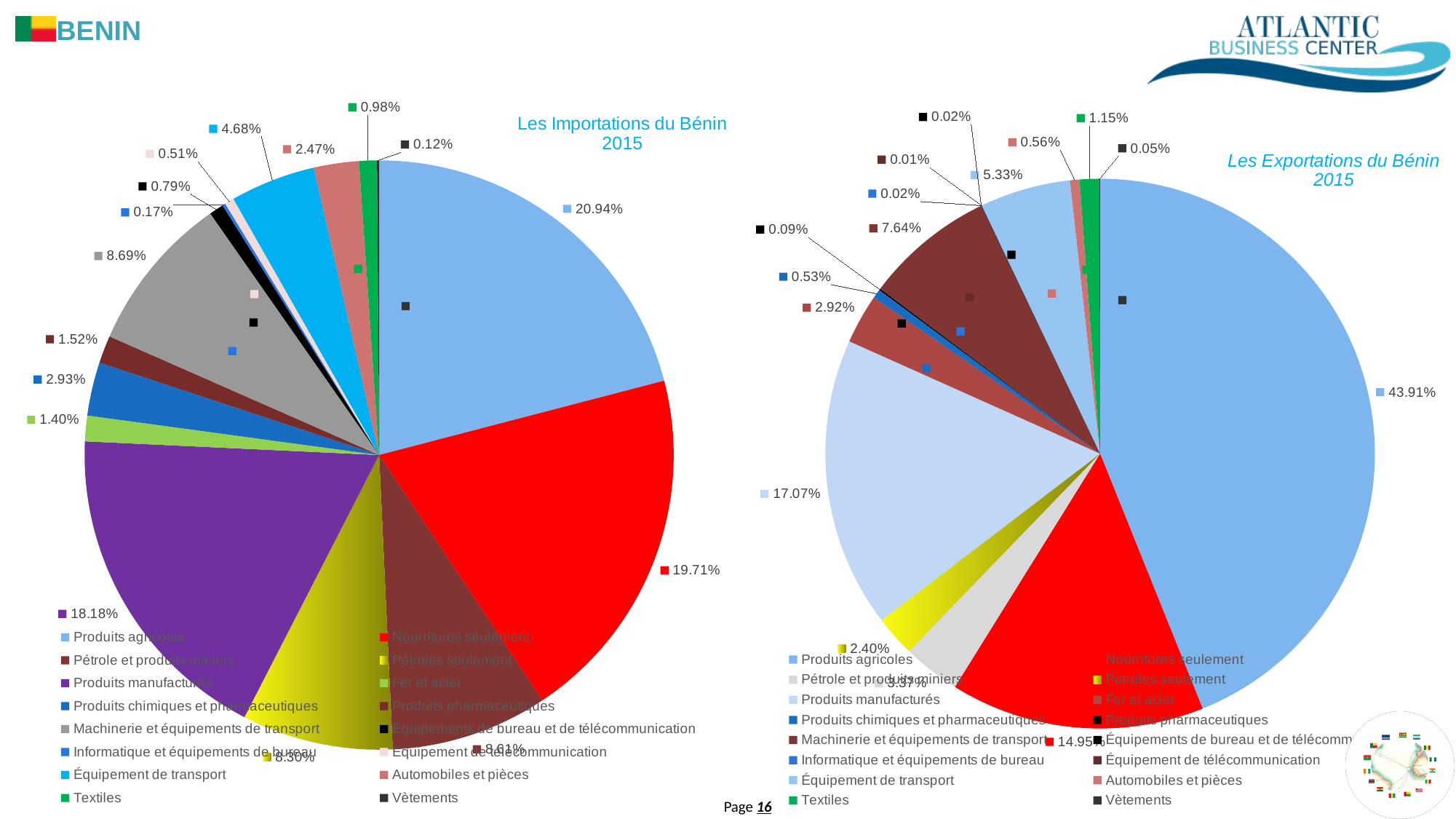
How many categories does the legend of the 'Les Importations du Bénin 2015' chart list? 16 In the 'Les Exportations du Bénin 2015' chart, what is the value for Nourritures seulement? 14.95% In the 'Les Importations du Bénin 2015' chart, what is the value for Nourritures seulement? 19.71% In the 'Les Exportations du Bénin 2015' chart, what is the difference between the Produits agricoles share and the Produits manufacturés share? 26.84% In the 'Les Exportations du Bénin 2015' chart, which category has the largest slice? Produits agricoles Which is larger: the Produits agricoles share in 'Les Importations du Bénin 2015' or in 'Les Exportations du Bénin 2015'? Les Exportations du Bénin 2015 In the 'Les Importations du Bénin 2015' chart, what is the difference between the Produits agricoles share and the Nourritures seulement share? 1.23% What type of chart is used for 'Les Importations du Bénin 2015'? Pie chart In the 'Les Exportations du Bénin 2015' chart, what is the value for Produits manufacturés? 17.07% In the 'Les Exportations du Bénin 2015' chart, what is the value for Produits agricoles? 43.91% In the 'Les Importations du Bénin 2015' chart, what is the value for Produits manufacturés? 18.18% In the 'Les Importations du Bénin 2015' chart, what share does Produits agricoles have? 20.94%